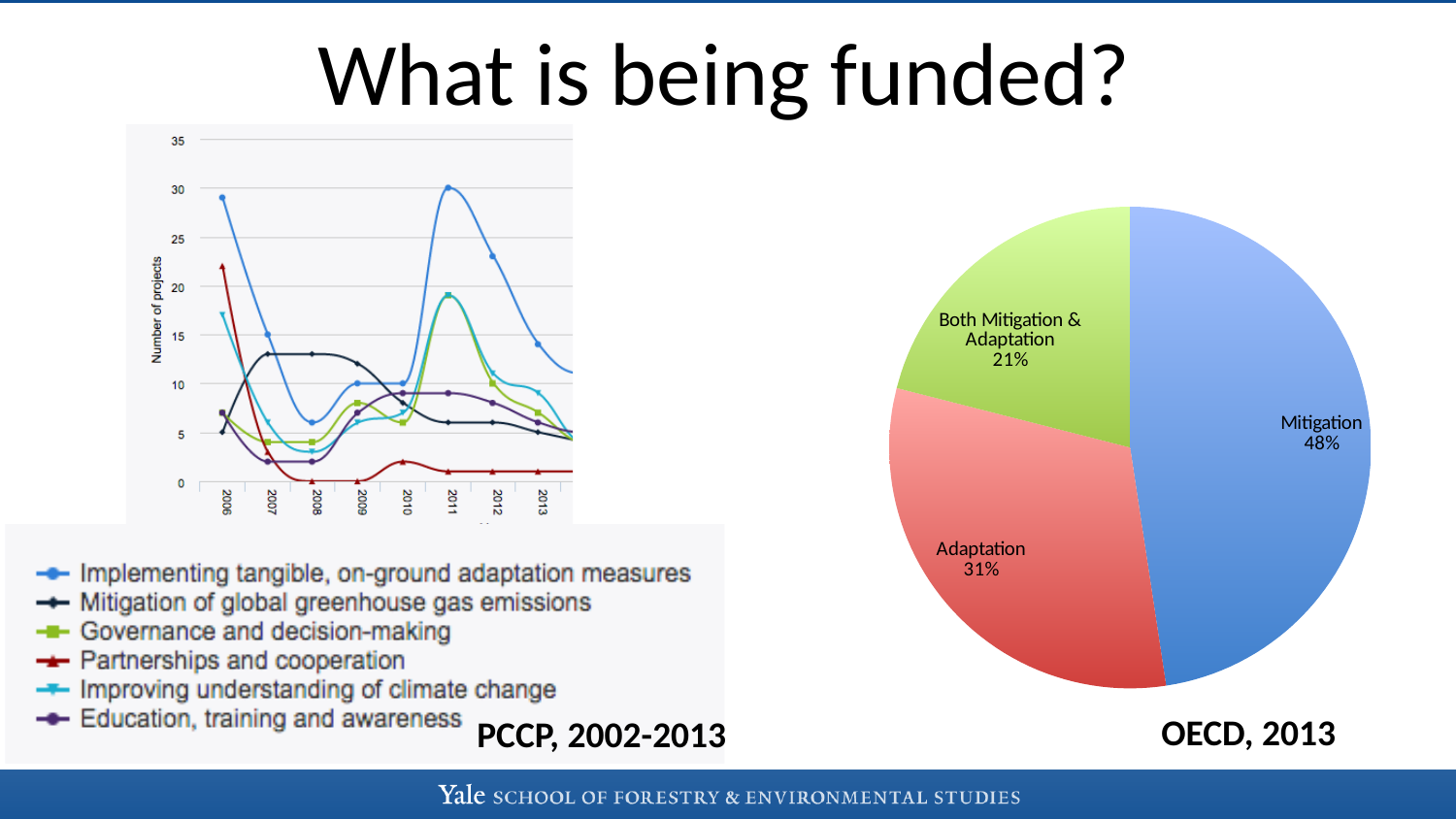
On the pie chart (OECD, 2013), what is the difference in percentage points between Mitigation and Adaptation? 17 On the pie chart (OECD, 2013), what share is labelled for Adaptation? 31% On the pie chart (OECD, 2013), how many slices are there? 3 On the pie chart (OECD, 2013), which category has the largest slice? Mitigation On the pie chart (OECD, 2013), which category has the smallest slice? Both Mitigation & Adaptation On the PCCP, 2002-2013 line chart, how many series does the legend list? 6 On the pie chart (OECD, 2013), what share is labelled for Both Mitigation & Adaptation? 21% On the PCCP, 2002-2013 line chart, is the value for Implementing tangible, on-ground adaptation measures in 2011 greater or less than 25? greater On the PCCP, 2002-2013 line chart, which series has the highest value in 2011? Implementing tangible, on-ground adaptation measures On the PCCP, 2002-2013 line chart, how many years are shown on the x axis? 8 On the pie chart (OECD, 2013), what share is labelled for Mitigation? 48% What kind of chart is the PCCP, 2002-2013 chart on the left? Line chart